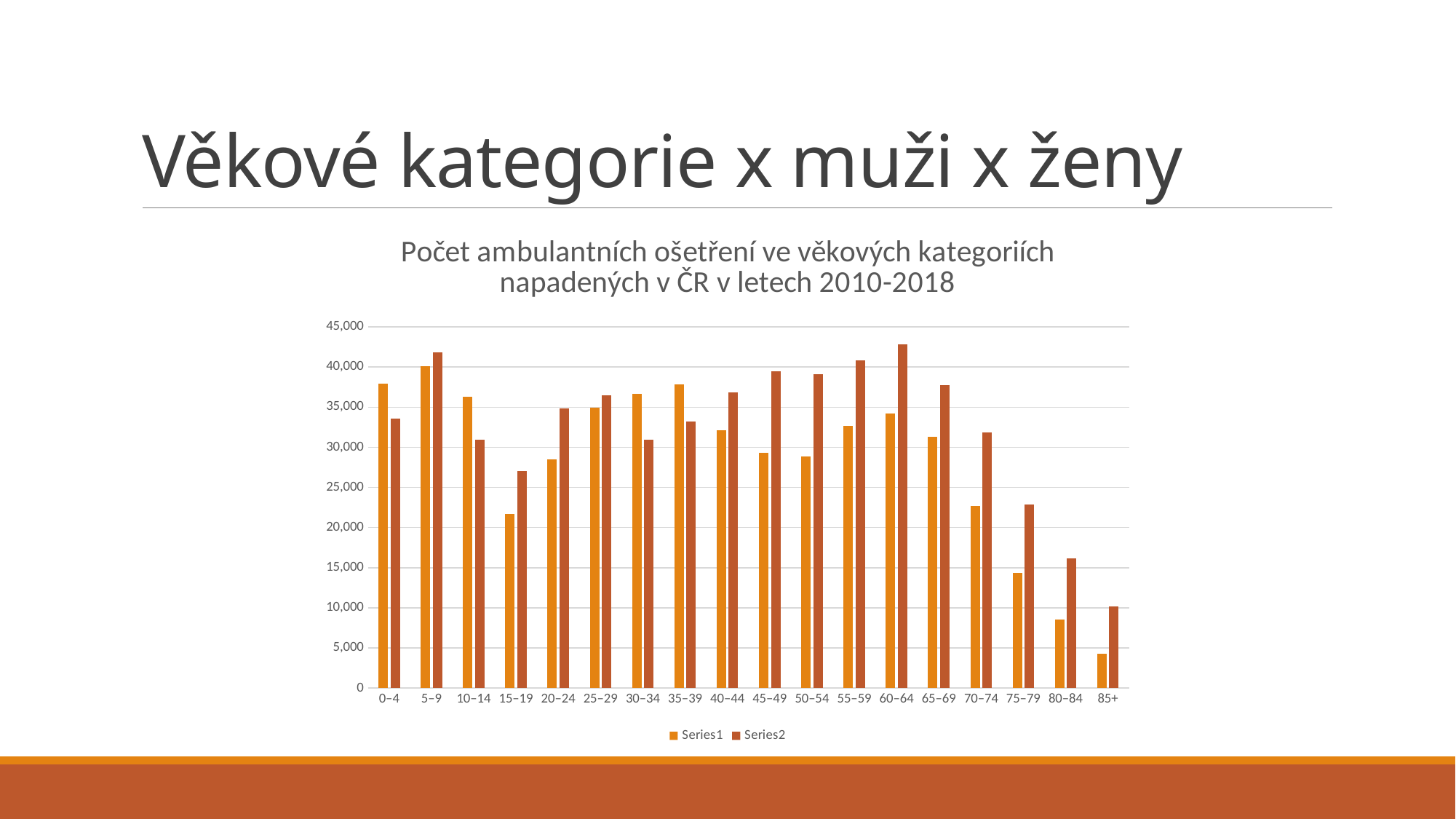
For the 45–49 category, which series has the larger value, Series1 or Series2? Series2 Which age category has the lowest value for Series2? 85+ What is the title of the chart? Počet ambulantních ošetření ve věkových kategoriích napadených v ČR v letech 2010-2018 Is the Series1 value for 85+ greater or less than 5,000? less Is the Series1 value for 75–79 greater or less than 15,000? less Is the Series1 value for 0–4 greater or less than 35,000? greater Which age category has the highest value for Series1? 5–9 What kind of chart is shown on the slide? bar chart For the 0–4 category, which series has the larger value, Series1 or Series2? Series1 How many series does the chart legend list? 2 How many age categories are shown on the x axis of the chart? 18